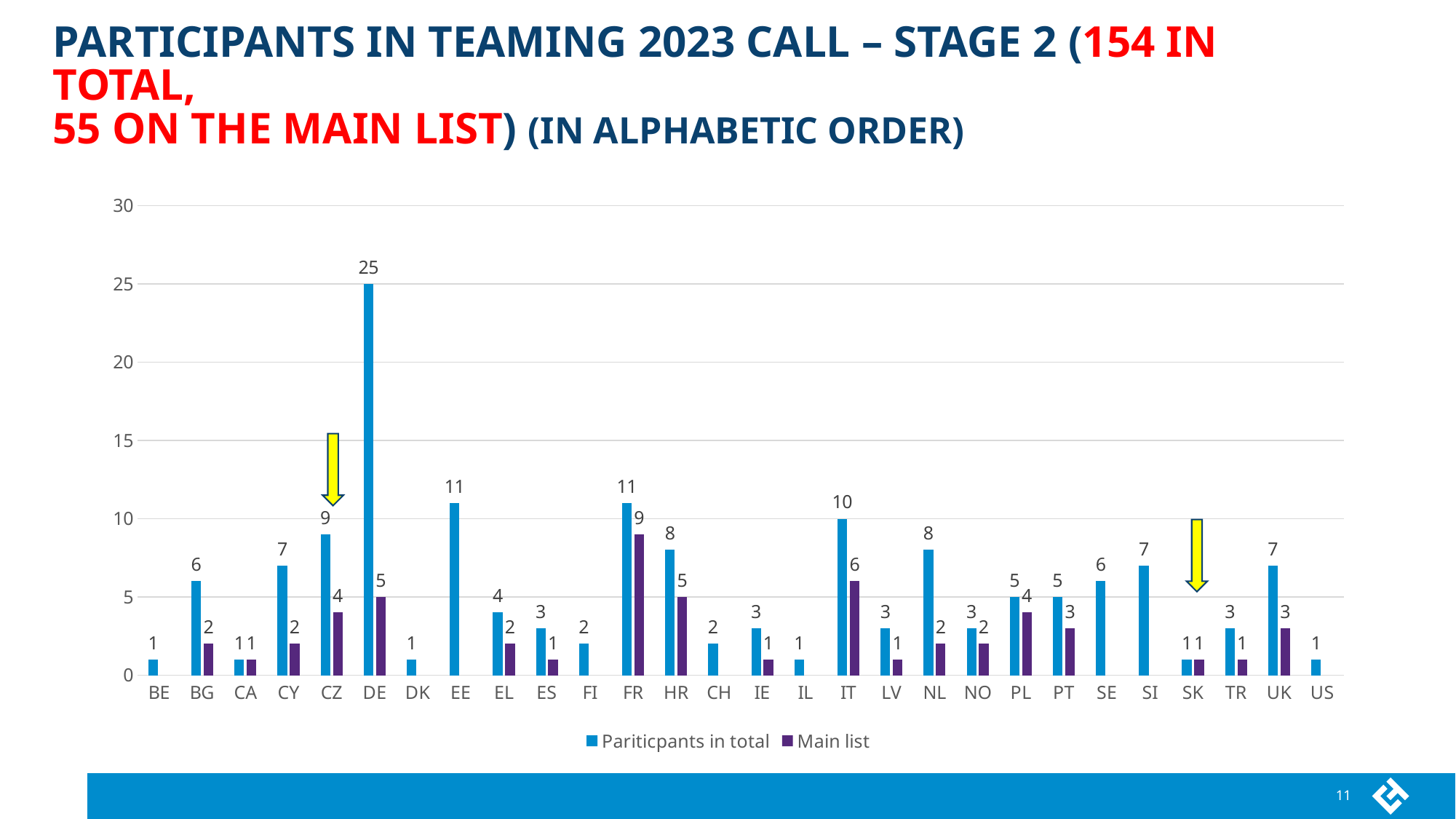
What is the difference between Participants in total and Main list for IT? 4 What is the value of Participants in total for DE? 25 What is the Main list value for FR? 9 Which country has the highest Main list value? FR Which country has the highest number of Participants in total? DE How many series does the legend list? 2 Is the value of Participants in total for DE greater or less than 20? greater How many countries are shown on the x axis? 28 What kind of chart is shown on the slide? bar chart What is the Main list value for PL? 4 Which has more Participants in total, EE or HR? EE What is the value of Participants in total for CZ? 9